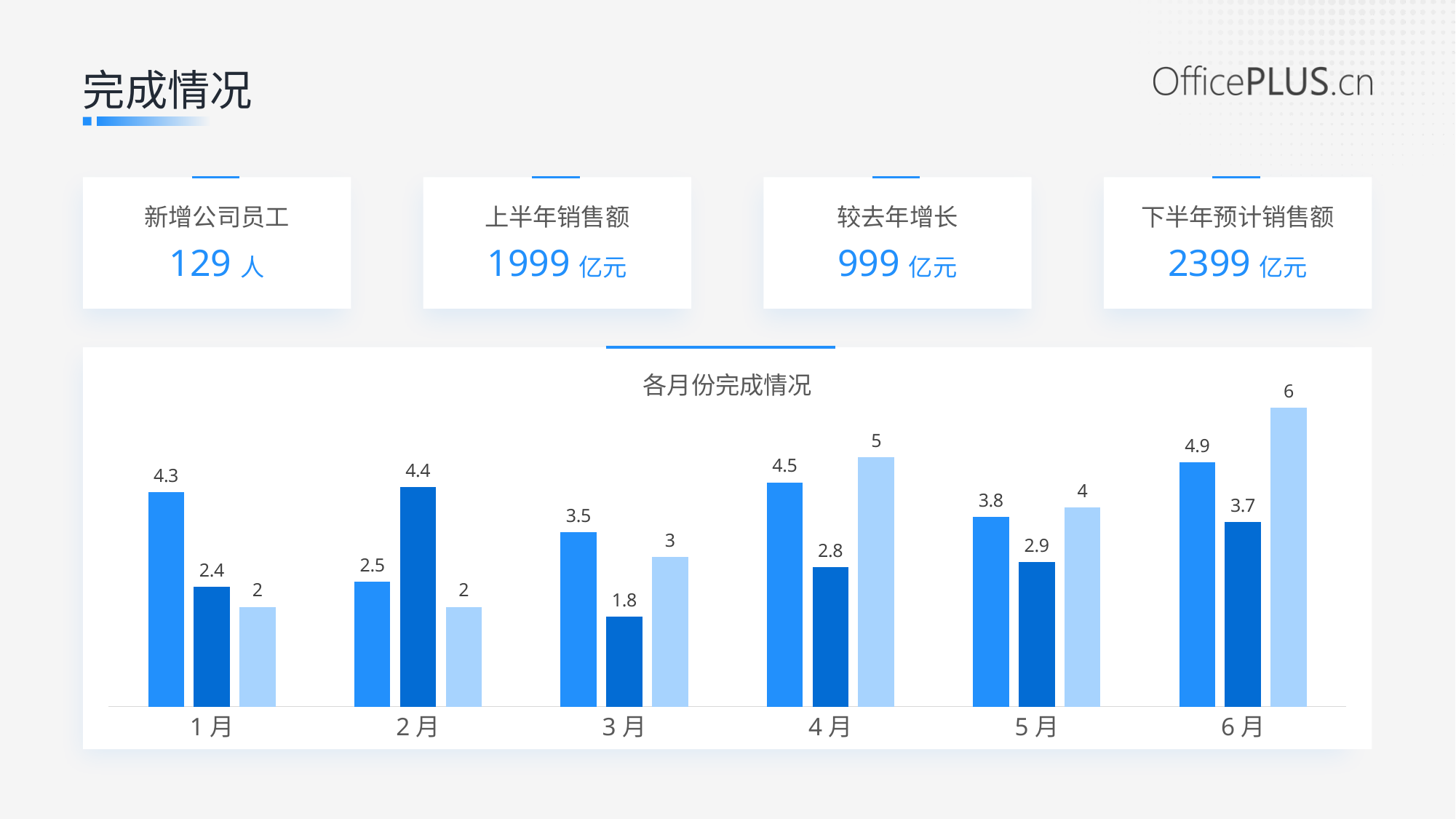
How many months are shown on the x axis of the chart? 6 What is the title of the chart? 各月份完成情况 Which month has the lowest dark blue bar? 3月 For 1月, which is larger: the medium blue (first) bar or the light blue (third) bar? the medium blue (first) bar What type of chart is shown on the slide? bar chart What is the difference between the light blue bar and the dark blue bar for 4月? 2.2 What is the value of the medium blue (first) bar for 2月? 2.5 Does the light blue bar rise or fall from 3月 to 6月? rise What is the value of the light blue bar for 6月? 6 What is the value of the dark blue bar for 3月? 1.8 Which month has the highest light blue bar? 6月 How many bars are plotted for each month in the chart? 3